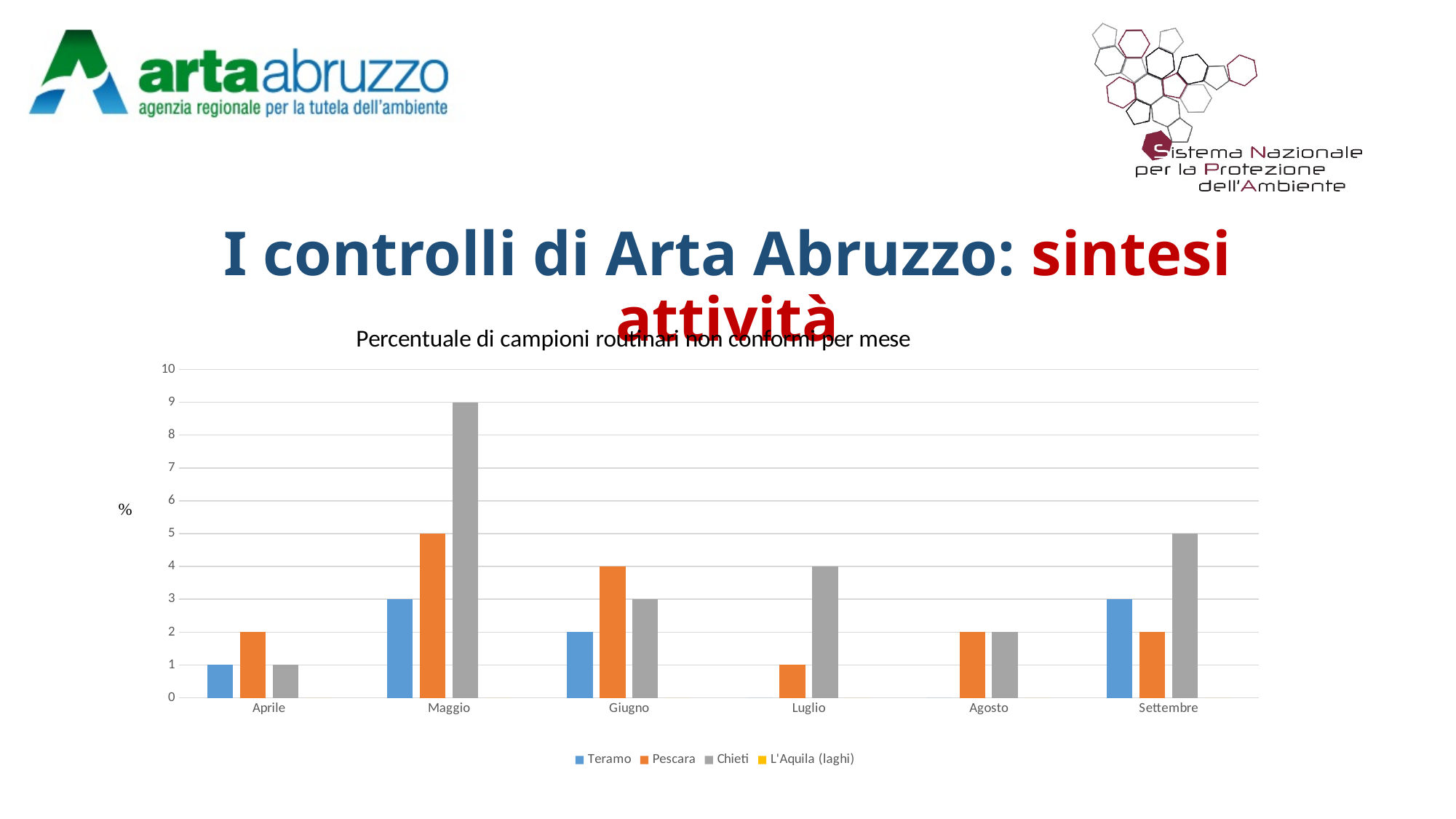
What is the value for Pescara in Maggio? 5 Which series has the lowest values across all months? L'Aquila (laghi) Is the value for Chieti in Luglio greater or less than 2? greater In which month does Chieti reach its highest value? Maggio What is the difference between Chieti and Teramo in Settembre? 2 How many months are shown on the x axis? 6 What kind of chart is shown on the slide? bar chart What is the title of the chart? Percentuale di campioni routinari non conformi per mese How many series does the legend list? 4 What is the value for Chieti in Maggio? 9 Which series is shown in grey in the legend? Chieti Which is larger in Giugno, Pescara or Chieti? Pescara